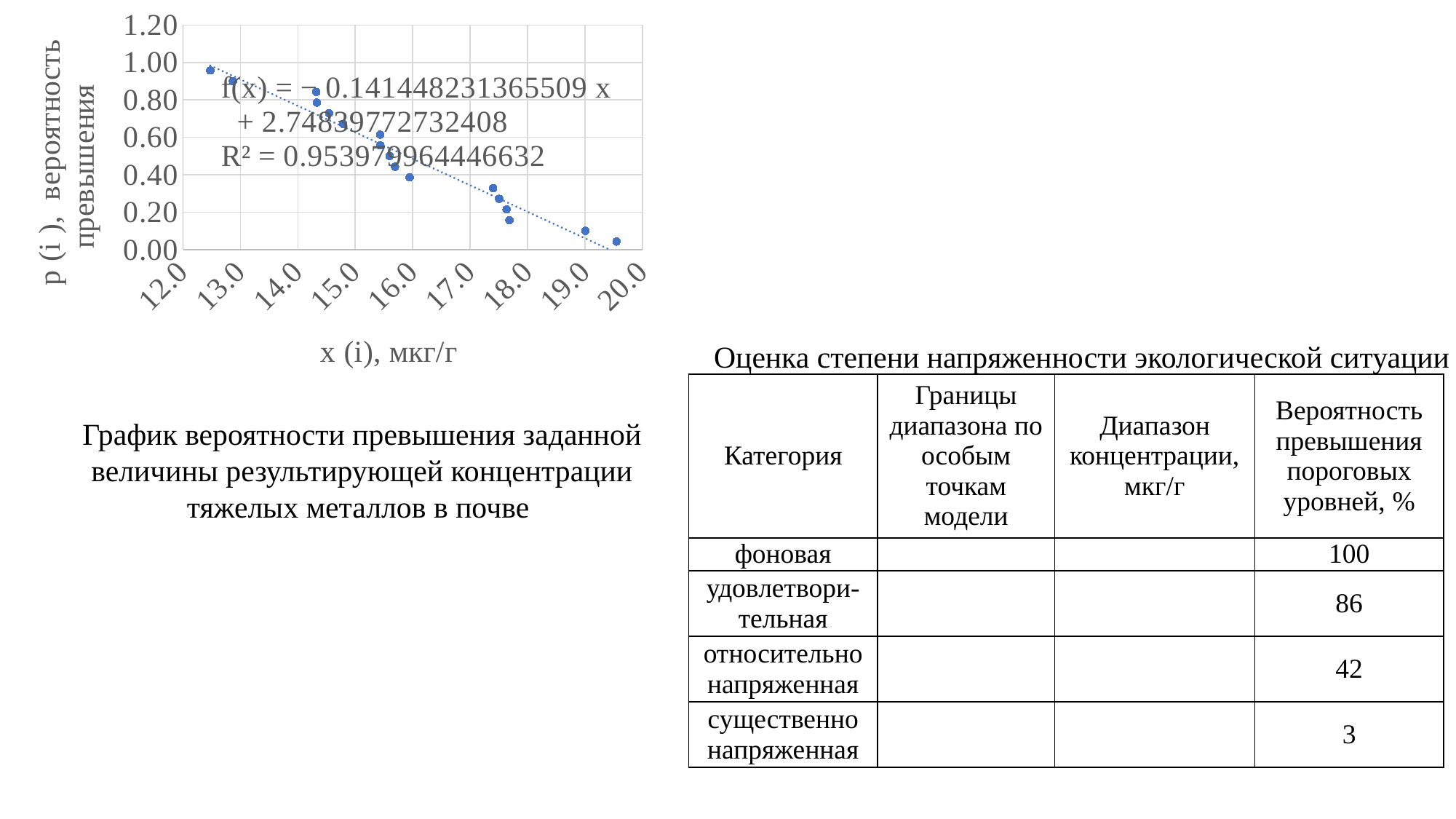
Which point has the highest probability value on the chart? The leftmost point Do the plotted probability values rise or fall as x (i) increases along the x axis? Fall What is the R² value shown on the chart? 0.953979964446632 Is the probability value for the rightmost point (near x = 19.6) greater or less than 0.20? less Which has the larger probability value: the leftmost point or the rightmost point? The leftmost point What kind of chart is shown on the slide? Scatter chart Is the probability value for the leftmost point (near x = 12.6) greater or less than 0.80? greater Which point has the lowest probability value on the chart? The rightmost point Is the probability value for the point near x = 16.0 greater or less than 0.60? less What is the label of the x axis of the chart? x (i), мкг/г